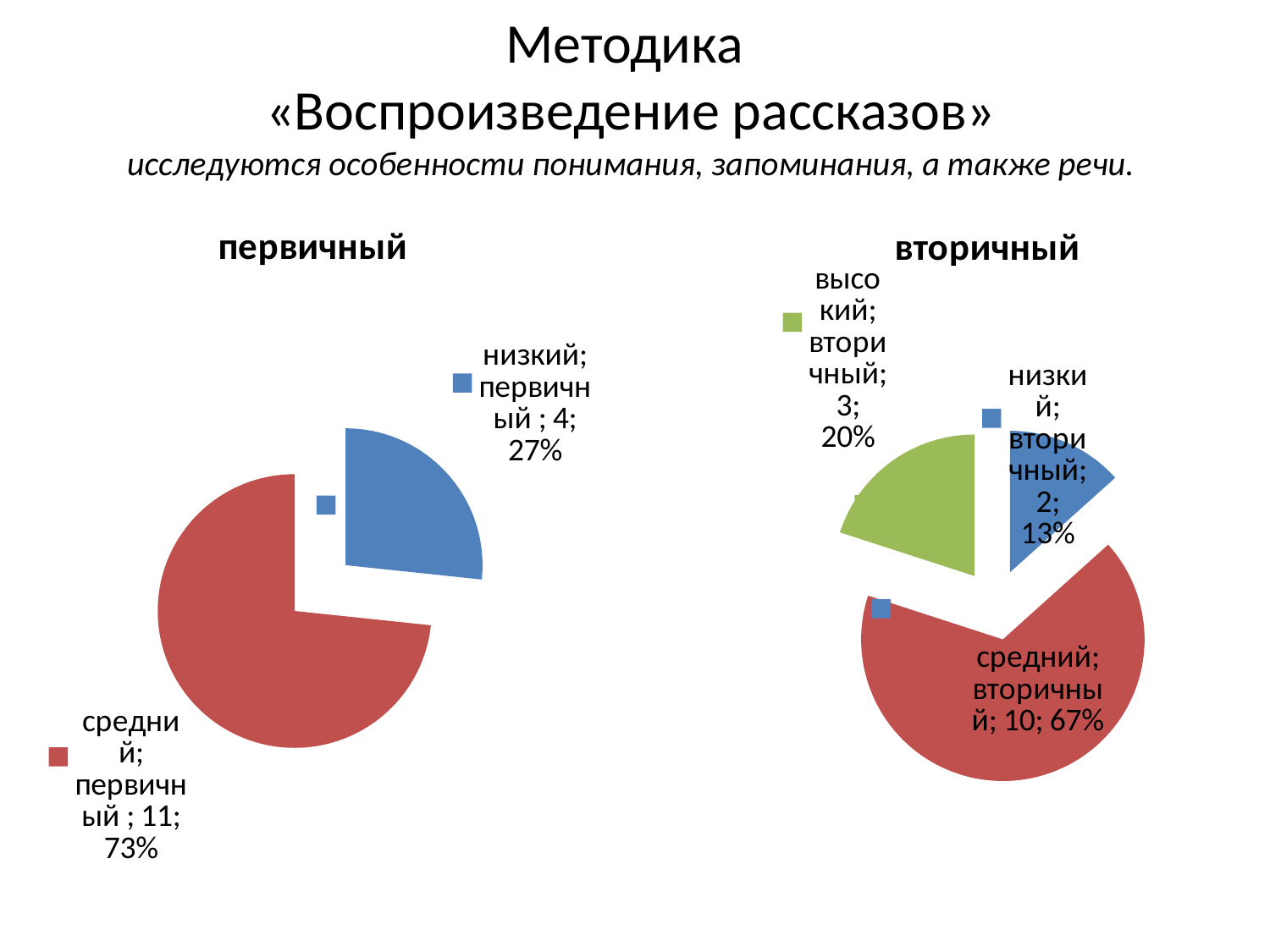
What colour is the "средний" slice in the "первичный" chart? red In the "вторичный" chart, what is the value for "высокий"? 3 What kind of chart is the "первичный" chart? pie chart In the "вторичный" chart, what share of the pie does "низкий" take? 13% In the "первичный" chart, what share of the pie does "средний" take? 73% In the "первичный" chart, what is the difference between the values for "средний" and "низкий"? 7 How many slices does the "вторичный" chart have? 3 In the "первичный" chart, which category is the largest? средний In the "вторичный" chart, what is the total of all three slices? 15 In the "вторичный" chart, which is larger, "высокий" or "низкий"? высокий In the "первичный" chart, what is the value for "низкий"? 4 In the "вторичный" chart, which category is the smallest? низкий